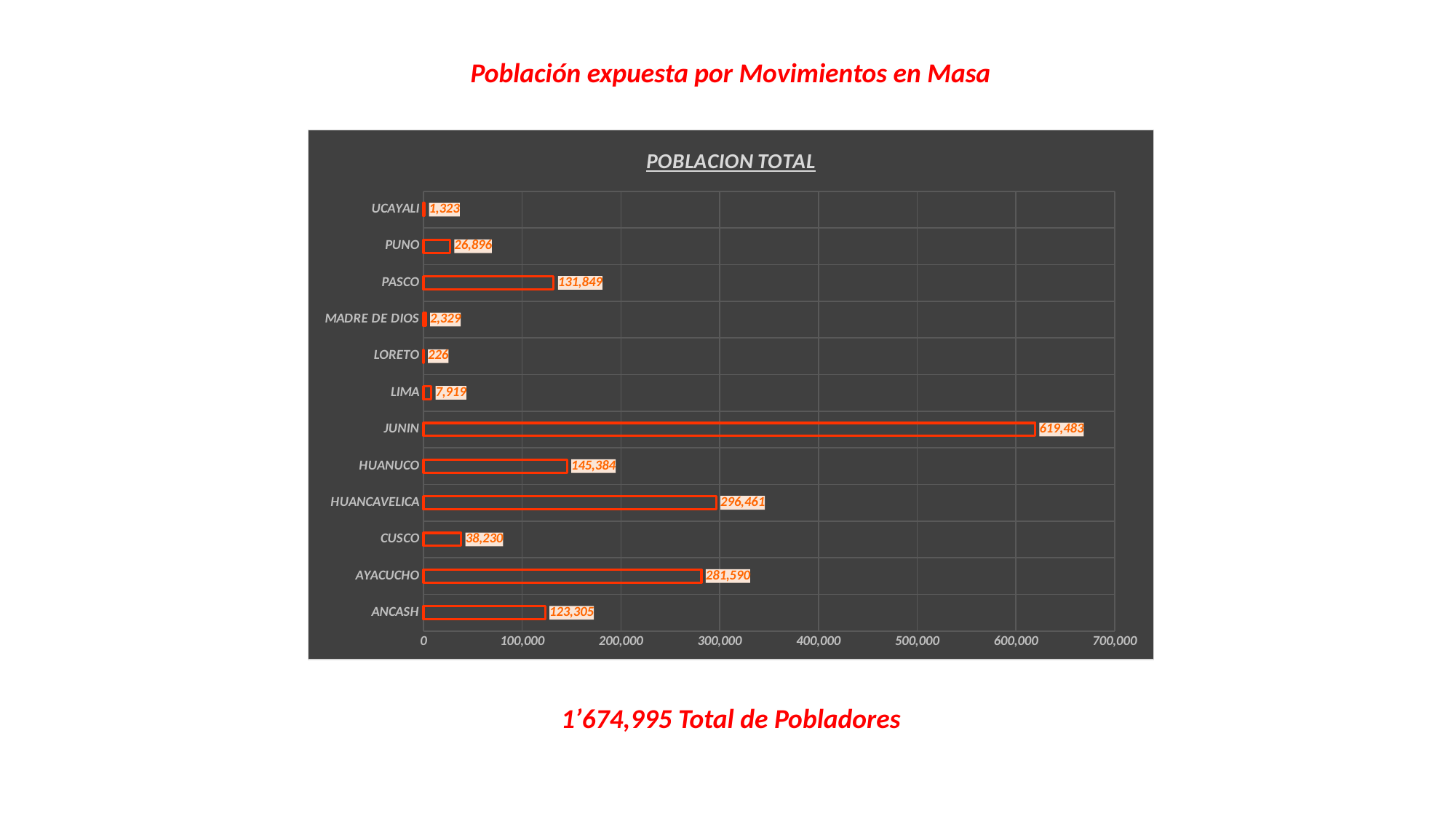
What is the difference between the values for HUANUCO and PASCO? 13,535 What is the value for LORETO? 226 How many categories are shown in the chart? 12 What is the title of the chart? POBLACION TOTAL What kind of chart is shown on the slide? Bar chart What is the difference between the values for HUANCAVELICA and AYACUCHO? 14,871 What is the value for HUANCAVELICA? 296,461 What is the value for ANCASH? 123,305 Which category has the lowest value? LORETO Which category has the highest value? JUNIN What is the value for JUNIN? 619,483 Which is larger, the value for CUSCO or the value for PUNO? CUSCO